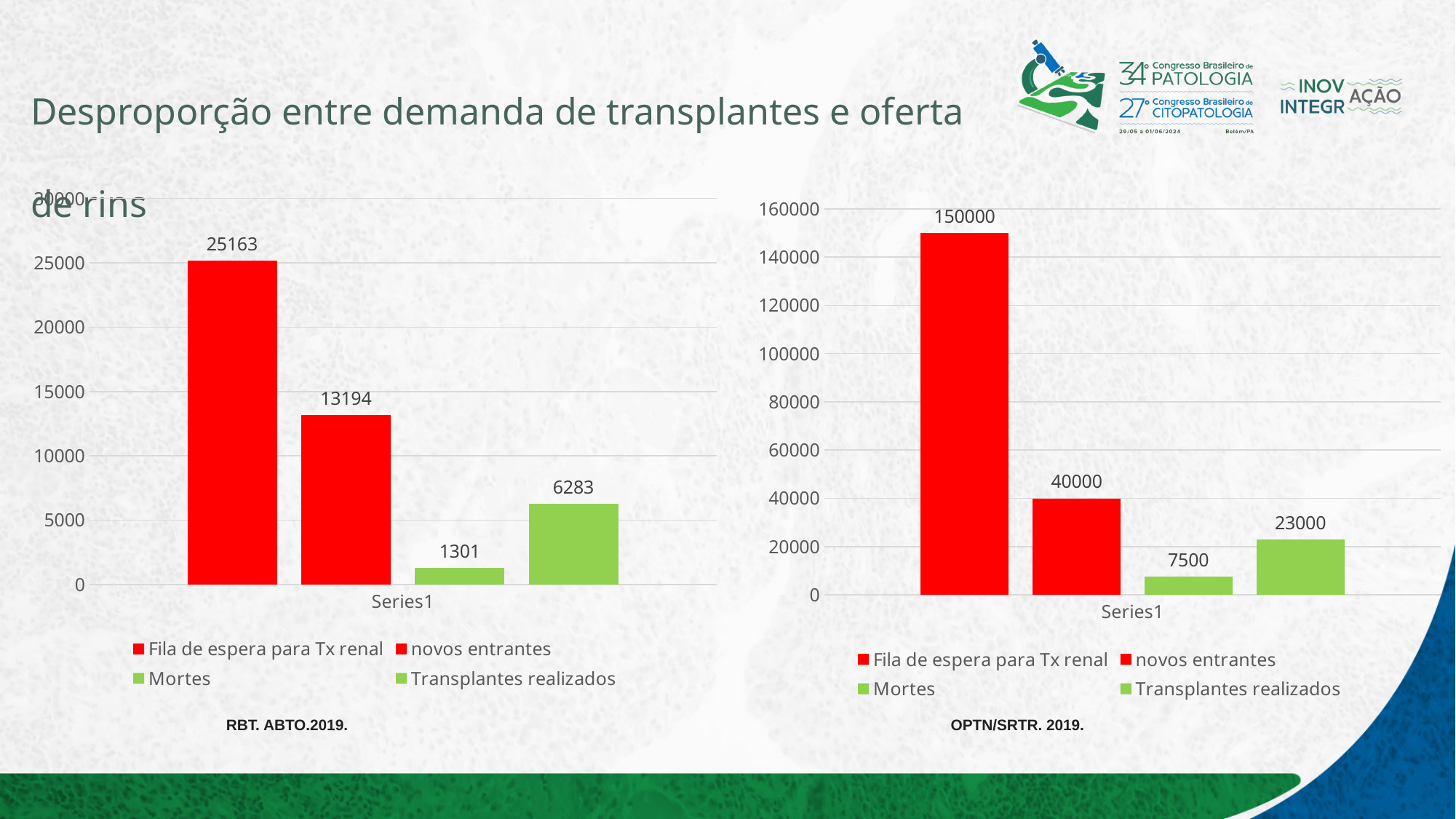
On the left chart, what is the value for Transplantes realizados? 6283 On the left chart, which series has the lowest value? Mortes On the right chart, what is the value for Mortes? 7500 On the right chart, which series has the highest value? Fila de espera para Tx renal On the left chart, what is the value for Fila de espera para Tx renal? 25163 On the left chart, which is larger: Transplantes realizados or Mortes? Transplantes realizados On the right chart, what is the difference between Transplantes realizados and Mortes? 15500 On the left chart, what is the difference between Fila de espera para Tx renal and novos entrantes? 11969 What kind of chart is the left chart? Bar chart On the right chart, what is the value for novos entrantes? 40000 How many series does the legend of the right chart list? 4 What source is cited below the right chart? OPTN/SRTR. 2019.